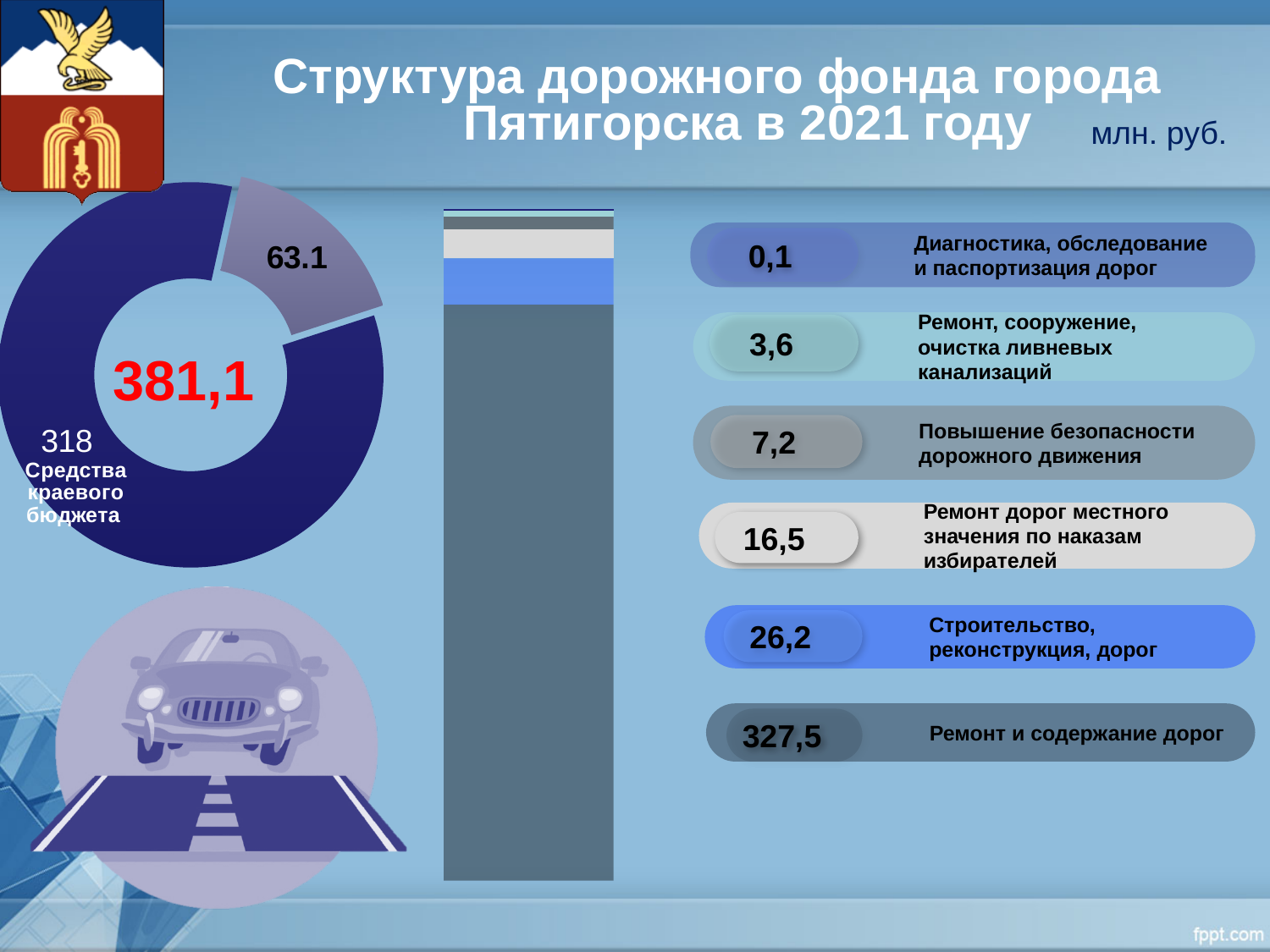
What kind of chart is shown on the left side of the slide? doughnut chart How many categories make up the stacked bar chart? 6 In the stacked bar chart, what is the difference between Строительство, реконструкция, дорог and Ремонт дорог местного значения по наказам избирателей? 9,7 In the stacked bar chart, what is the value for Ремонт и содержание дорог? 327,5 In the pie chart on the left, which slice is the largest? Средства краевого бюджета In the pie chart on the left, what is the value for Средства краевого бюджета? 318 In the stacked bar chart, which category has the smallest value? Диагностика, обследование и паспортизация дорог In the stacked bar chart, what is the value for Строительство, реконструкция, дорог? 26,2 How many slices does the pie chart on the left have? 2 What kind of chart is the tall chart in the middle of the slide? bar chart In the stacked bar chart, which is larger: Ремонт, сооружение, очистка ливневых канализаций or Повышение безопасности дорожного движения? Повышение безопасности дорожного движения What total value is printed in the centre of the pie chart on the left? 381,1